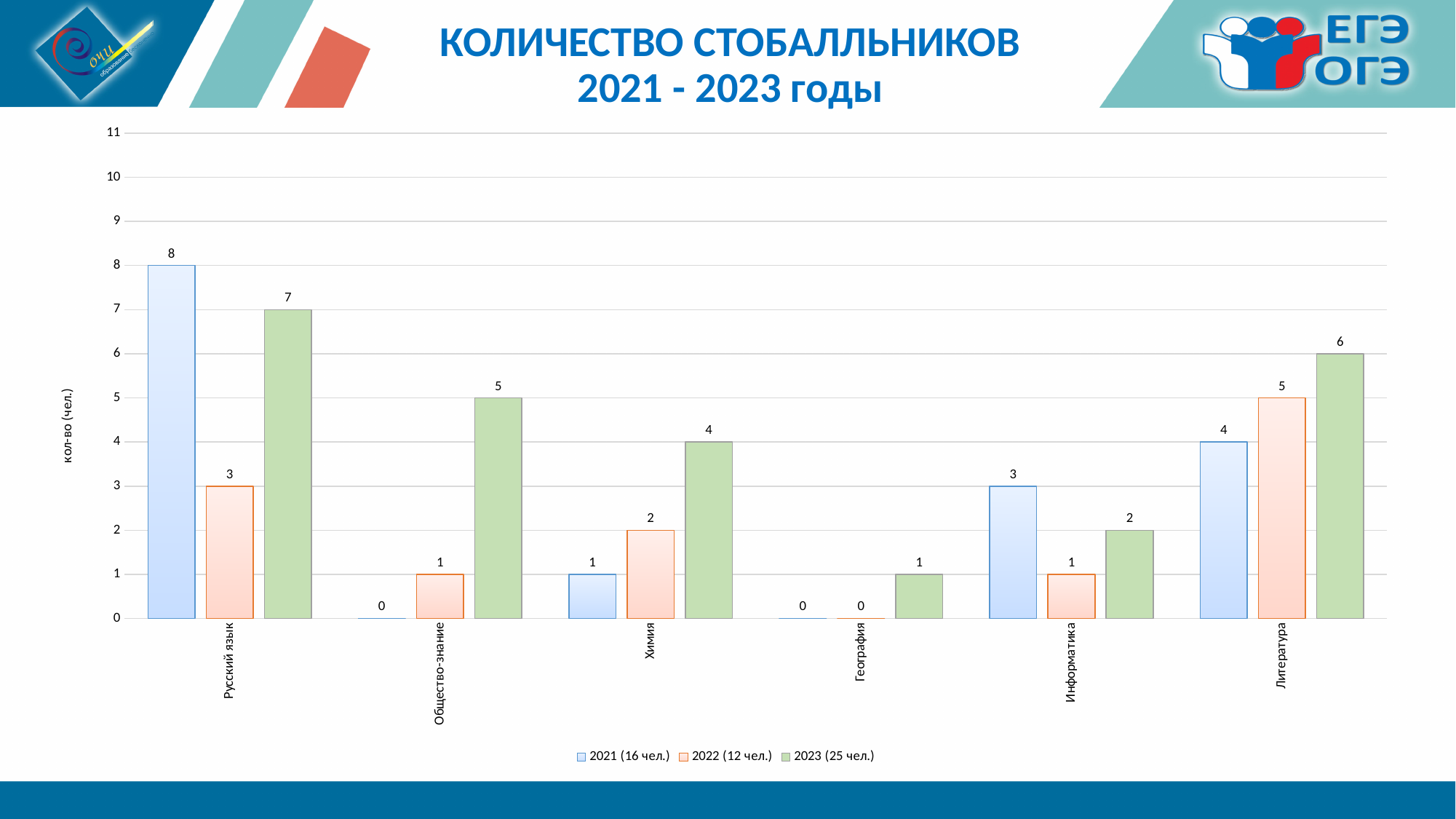
What is the difference between the 2023 and 2022 values for Обществознание? 4 What is the label of the y axis? кол-во (чел.) Which category has the highest value in the 2023 series? Русский язык Which category has the lowest value in the 2023 series? География What is the title of the chart? КОЛИЧЕСТВО СТОБАЛЛЬНИКОВ 2021 - 2023 годы What is the value for Химия in the 2023 series? 4 What kind of chart is shown on the slide? Bar chart What is the value for Русский язык in the 2021 series? 8 What is the value for Литература in the 2022 series? 5 Which is larger for Информатика: the 2021 value or the 2023 value? 2021 How many categories are shown on the x axis? 6 How many series does the legend list? 3